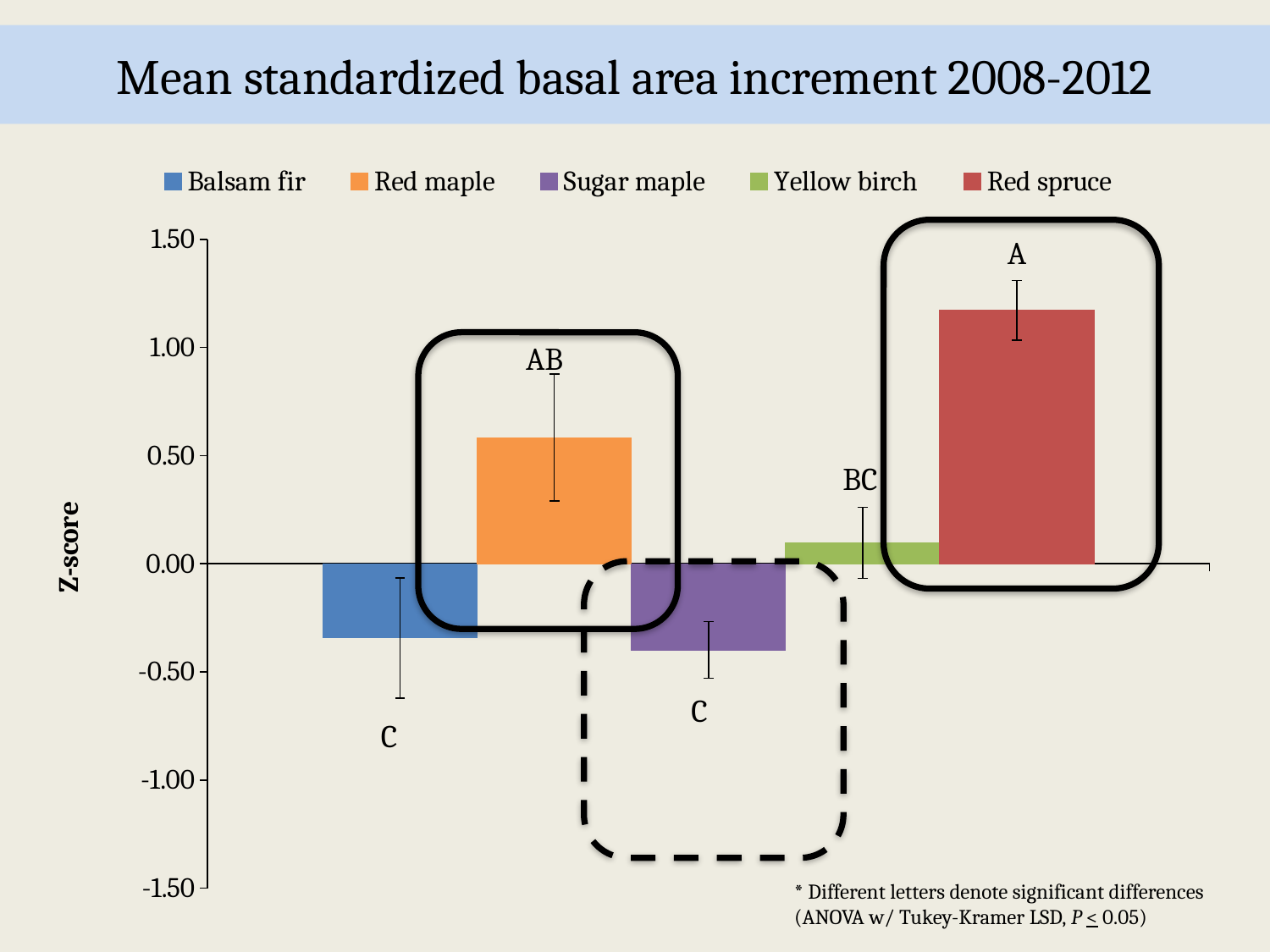
Is the value for Sugar maple greater or less than -0.50? greater What is the title of the chart? Mean standardized basal area increment 2008-2012 Is the value for Balsam fir greater or less than 0.00? less Is the value for Yellow birch greater or less than 0.50? less Which species has the highest mean standardized basal area increment? Red spruce What kind of chart is shown on the slide? bar chart How many series does the legend list? 5 What is the label on the vertical axis? Z-score Which is larger, the value for Red maple or the value for Yellow birch? Red maple Which is larger, the value for Red spruce or the value for Red maple? Red spruce